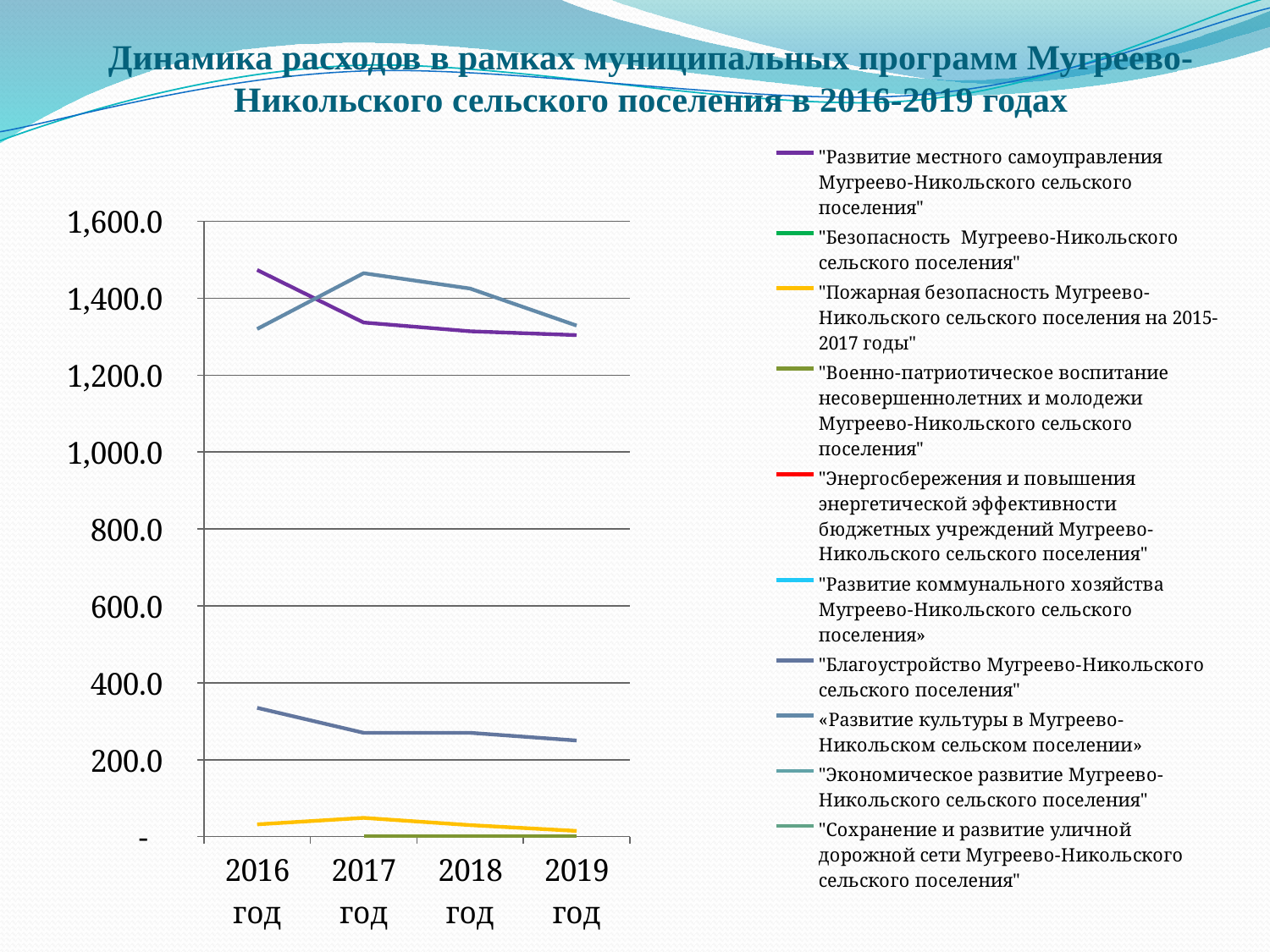
Does the line for "Развитие местного самоуправления Мугреево-Никольского сельского поселения" rise or fall from 2016 to 2019? fall Is the 2016 value for "Развитие местного самоуправления Мугреево-Никольского сельского поселения" greater or less than 1,400.0? greater Is the 2019 value for "Развитие местного самоуправления Мугреево-Никольского сельского поселения" greater or less than 1,400.0? less For "Развитие местного самоуправления Мугреево-Никольского сельского поселения", which is larger: the 2016 value or the 2019 value? 2016 In which year is the value for "Развитие местного самоуправления Мугреево-Никольского сельского поселения" highest? 2016 год How many series does the legend list? 10 What colour is the line for "Развитие местного самоуправления Мугреево-Никольского сельского поселения" in the legend? purple What is the highest value shown on the y axis? 1,600.0 How many years are plotted along the x axis? 4 What kind of chart is shown on the slide? line chart Is the 2017 value for "Пожарная безопасность Мугреево-Никольского сельского поселения на 2015-2017 годы" greater or less than 200.0? less